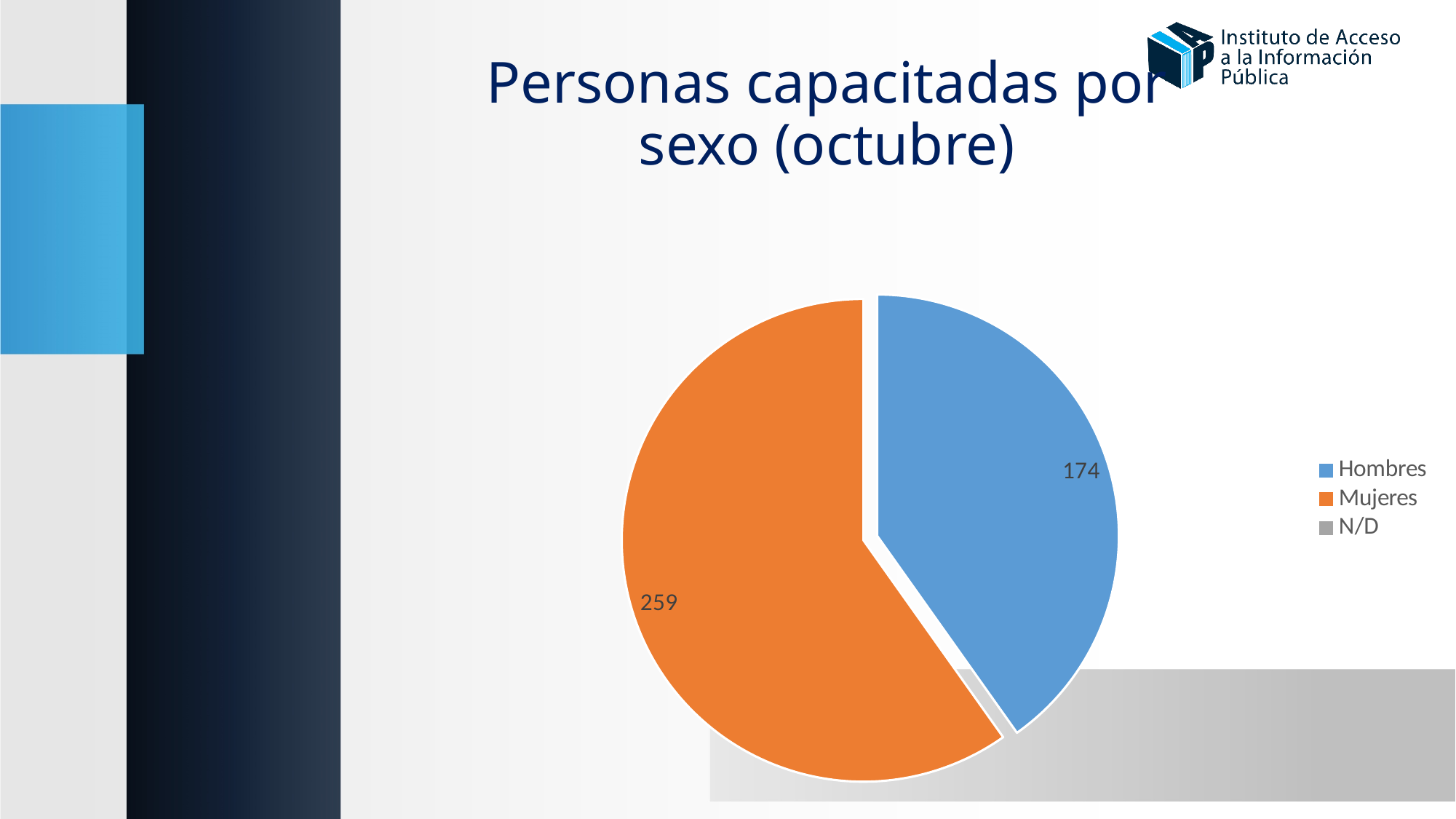
What is the value for Mujeres in the pie chart? 259 What kind of chart is shown on the slide? pie chart What is the value for Hombres in the pie chart? 174 Is the value for Mujeres larger or smaller than the value for Hombres? larger How many slices with data labels are visible in the pie chart? 2 Which category has the largest slice in the pie chart? Mujeres Which colour represents Mujeres in the pie chart? orange What is the title of the chart on the slide? Personas capacitadas por sexo (octubre) Which of the two labelled slices, Hombres or Mujeres, is smaller? Hombres How many categories does the legend of the pie chart list? 3 What is the difference between the values for Mujeres and Hombres? 85